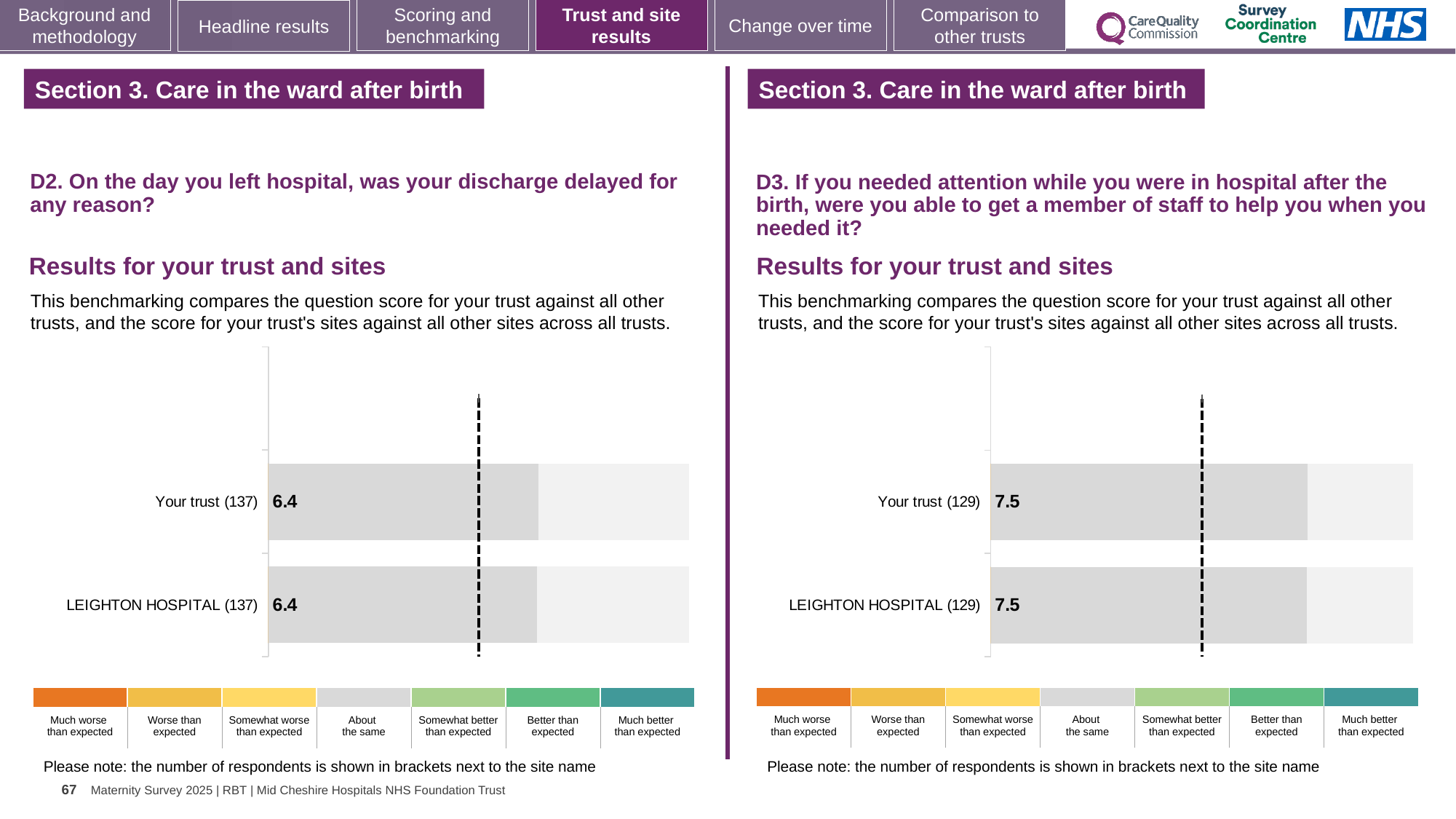
How many bars are plotted in the D3 chart on the right? 2 In the D2 chart on the left, which benchmarking category does the grey colour of the bars correspond to in the legend? About the same In the D2 chart on the left, what is the score for Your trust? 6.4 In the D3 chart on the right, what is the score for LEIGHTON HOSPITAL? 7.5 Which is larger: the Your trust score in the D2 chart on the left or the Your trust score in the D3 chart on the right? D3 chart on the right In the D3 chart on the right, how many respondents are shown in brackets for LEIGHTON HOSPITAL? 129 In the D3 chart on the right, what is the score for Your trust? 7.5 In the D2 chart on the left, how many respondents are shown in brackets for Your trust? 137 How many bars are plotted in the D2 chart on the left? 2 What kind of chart is the D3 chart on the right? Bar chart In the D2 chart on the left, what is the score for LEIGHTON HOSPITAL? 6.4 What is the difference between the Your trust score in the D3 chart on the right and the Your trust score in the D2 chart on the left? 1.1